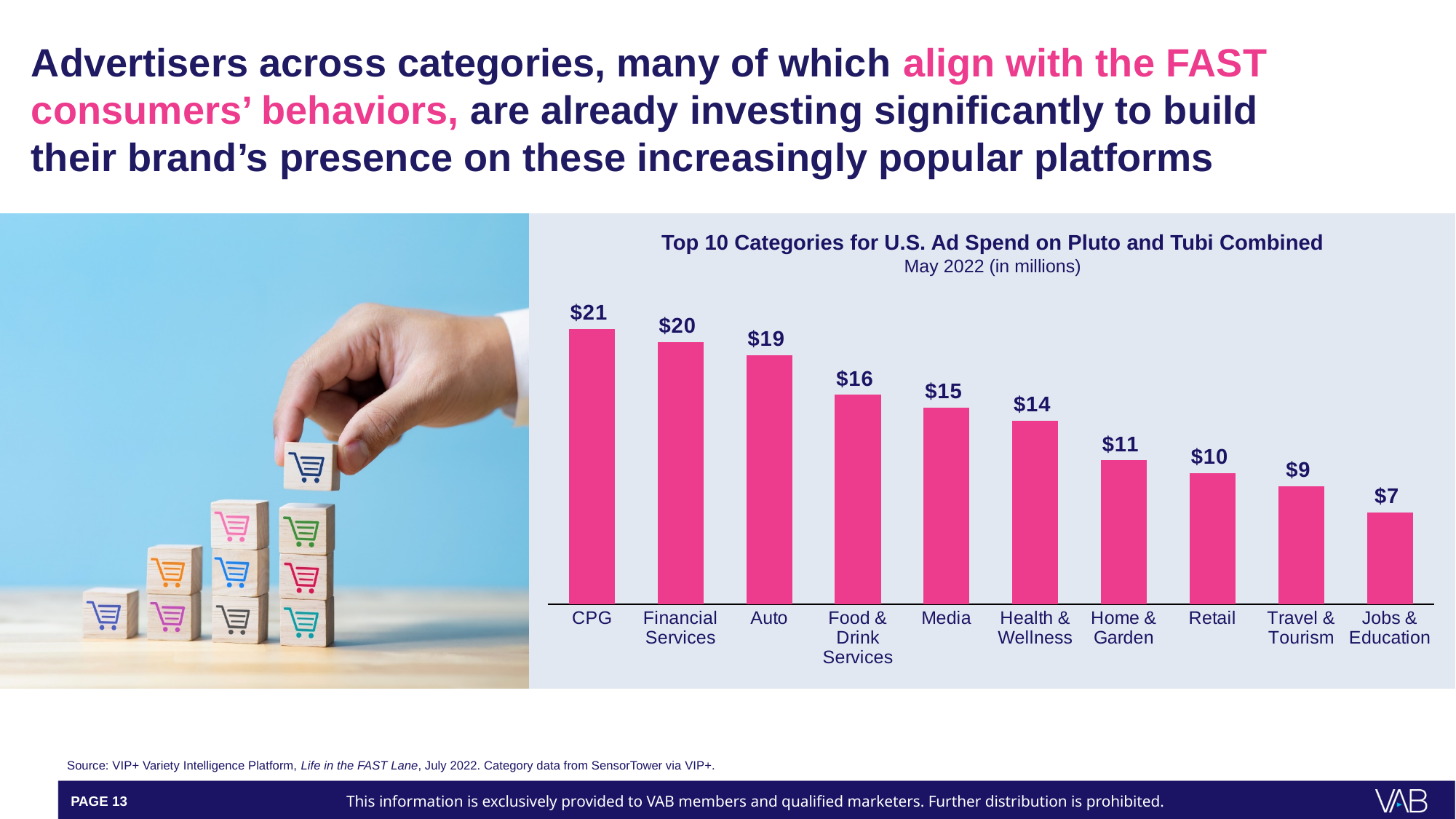
What is the difference between the ad spend for Financial Services and for Media? $5 What is the title of the chart? Top 10 Categories for U.S. Ad Spend on Pluto and Tubi Combined What is the ad spend value for Travel & Tourism? $9 What is the ad spend value for CPG? $21 Do the values rise or fall from left to right across the categories? Fall Which category has the highest ad spend? CPG How many categories are shown in the chart? 10 What kind of chart is shown on the slide? Bar chart What is the difference between the ad spend for Auto and for Retail? $9 Which has a larger ad spend, Food & Drink Services or Home & Garden? Food & Drink Services Which category has the lowest ad spend? Jobs & Education What is the ad spend value for Health & Wellness? $14